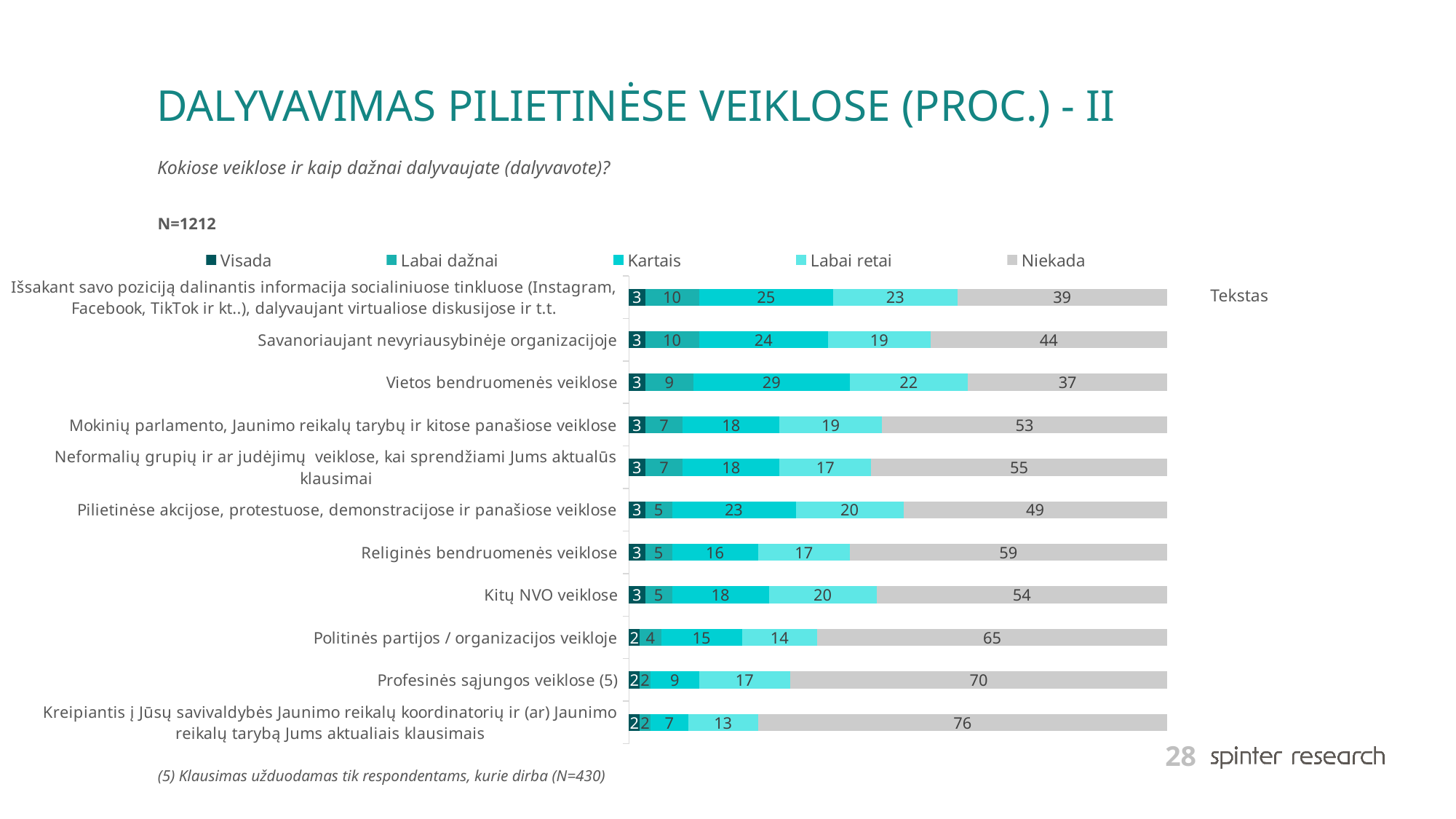
How many categories are shown in the chart? 11 What is the difference between the "Niekada" values for "Profesinės sąjungos veiklose (5)" and "Religinės bendruomenės veiklose"? 11 Which has a larger "Kartais" value: "Pilietinėse akcijose, protestuose, demonstracijose ir panašiose veiklose" or "Religinės bendruomenės veiklose"? Pilietinėse akcijose, protestuose, demonstracijose ir panašiose veiklose What is the "Labai retai" value for "Politinės partijos / organizacijos veikloje"? 14 Which category has the lowest "Niekada" value? Vietos bendruomenės veiklose What is the sample size (N) stated on the slide? N=1212 What is the "Niekada" value for "Vietos bendruomenės veiklose"? 37 What kind of chart is shown on the slide? Stacked bar chart How many series does the legend list? 5 Which category has the highest "Niekada" value? Kreipiantis į Jūsų savivaldybės Jaunimo reikalų koordinatorių ir (ar) Jaunimo reikalų tarybą Jums aktualiais klausimais What is the "Kartais" value for "Savanoriaujant nevyriausybinėje organizacijoje"? 24 What is the total of the stacked bar for "Kitų NVO veiklose"? 100